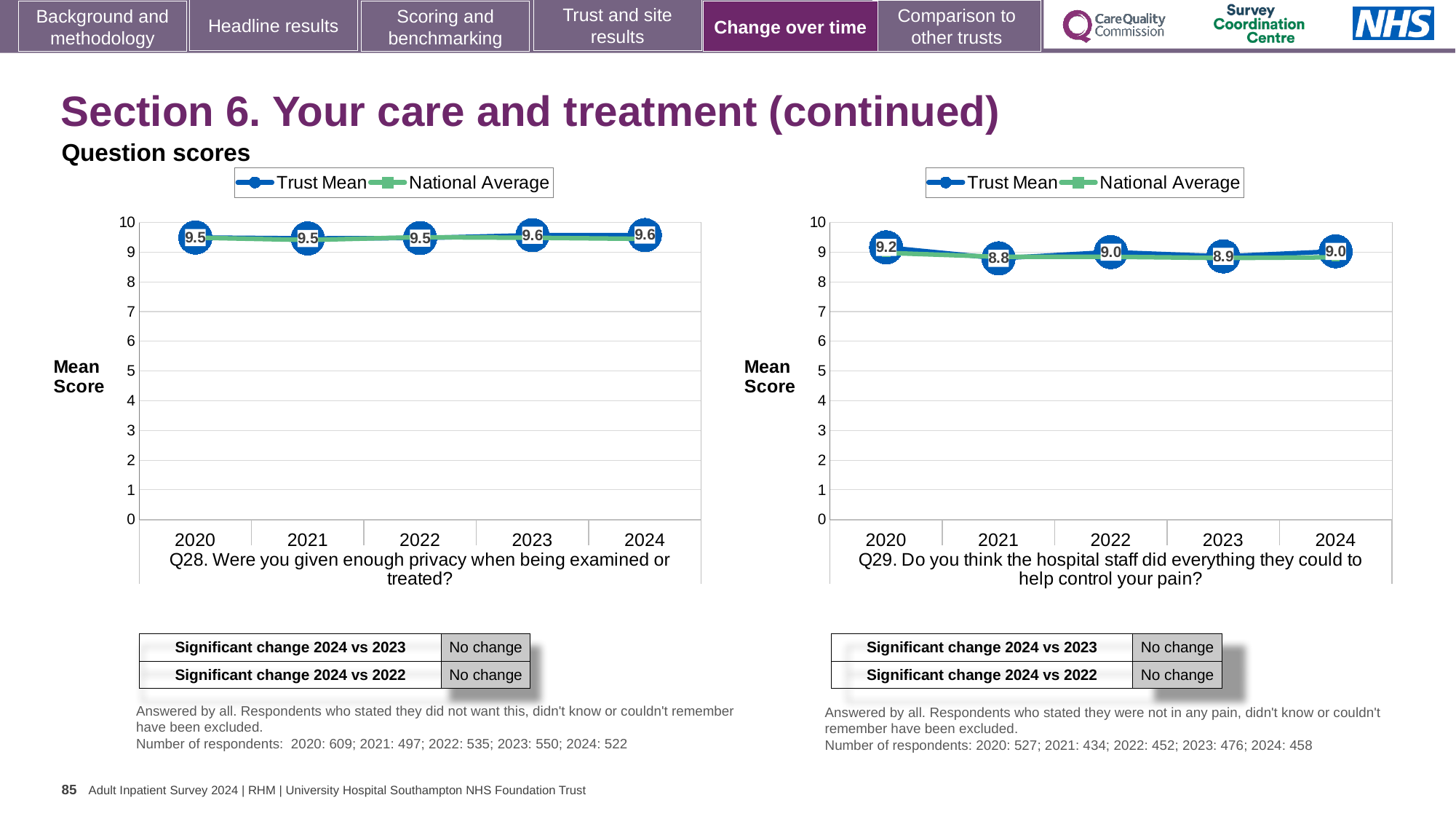
On the Q28 chart (left), what is the Trust Mean score for 2020? 9.5 On the Q29 chart (right), what is the Trust Mean score for 2020? 9.2 How many series does the legend of the Q29 chart (right) list? 2 On the Q28 chart (left), is the Trust Mean score for 2022 larger or smaller than the score for 2024? smaller On the Q28 chart (left), what is the Trust Mean score for 2024? 9.6 What type of chart is used for Q28 (left)? Line chart On the Q29 chart (right), what is the difference between the Trust Mean scores for 2020 and 2021? 0.4 On the Q29 chart (right), which year has the lowest Trust Mean score? 2021 How many years are shown on the x axis of the Q28 chart (left)? 5 On the Q29 chart (right), is the Trust Mean value for 2023 greater or less than 5? greater On the Q29 chart (right), what is the Trust Mean score for 2021? 8.8 On the Q29 chart (right), which year has the highest Trust Mean score? 2020